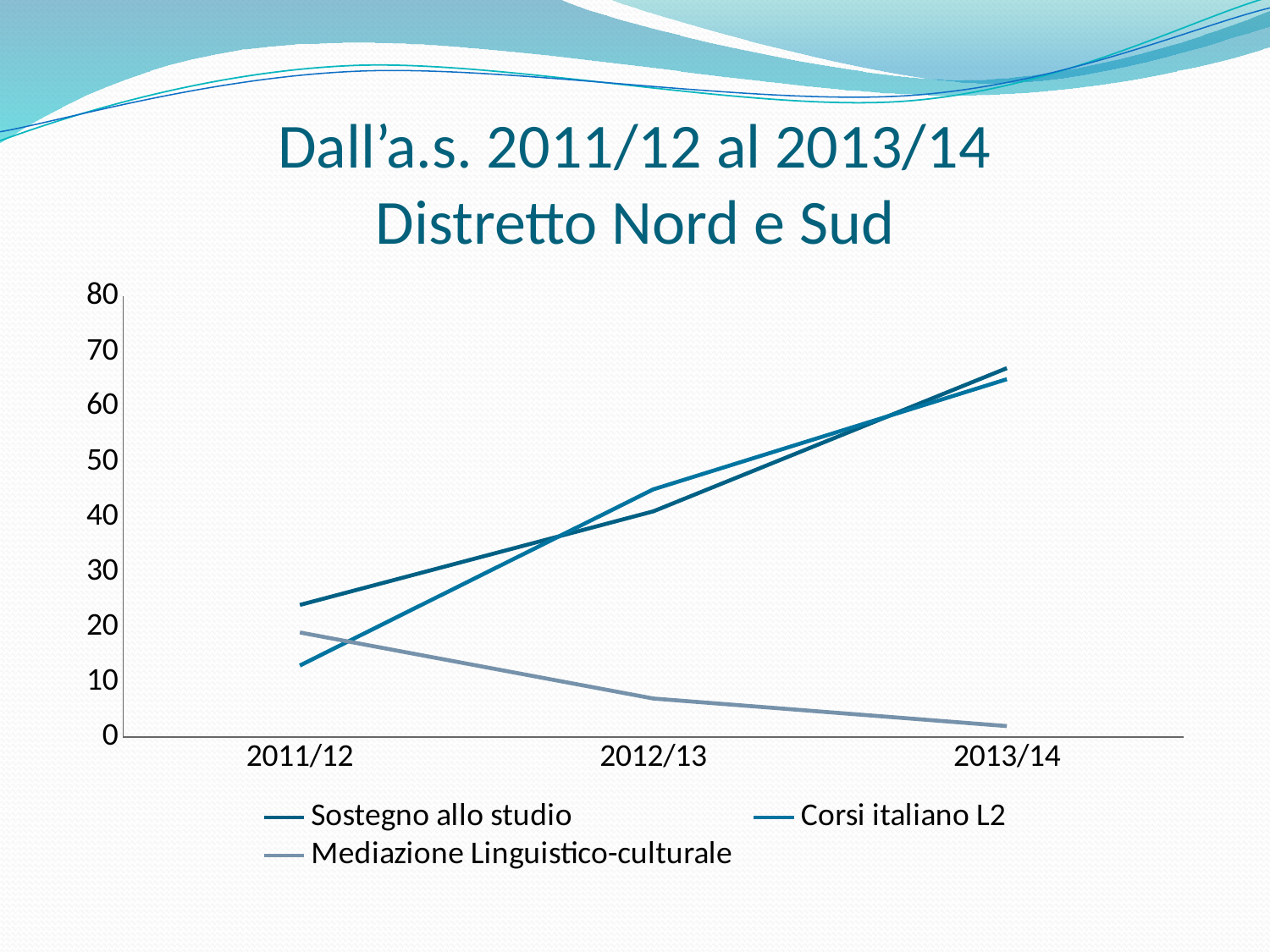
How many series does the legend list? 3 In 2013/14, which is larger: Sostegno allo studio or Mediazione Linguistico-culturale? Sostegno allo studio What kind of chart is shown on the slide? line chart Does the value for Sostegno allo studio rise or fall from 2011/12 to 2013/14? rise Is the value for Sostegno allo studio in 2013/14 greater or less than 60? greater What is the title of the slide above the chart? Dall'a.s. 2011/12 al 2013/14 Distretto Nord e Sud Does the value for Corsi italiano L2 rise or fall from 2011/12 to 2013/14? rise How many school years are shown on the x axis? 3 Does the value for Mediazione Linguistico-culturale rise or fall from 2011/12 to 2013/14? fall Which series has the lowest value in 2013/14? Mediazione Linguistico-culturale Is the value for Corsi italiano L2 in 2011/12 greater or less than 30? less Is the value for Mediazione Linguistico-culturale in 2013/14 greater or less than 10? less